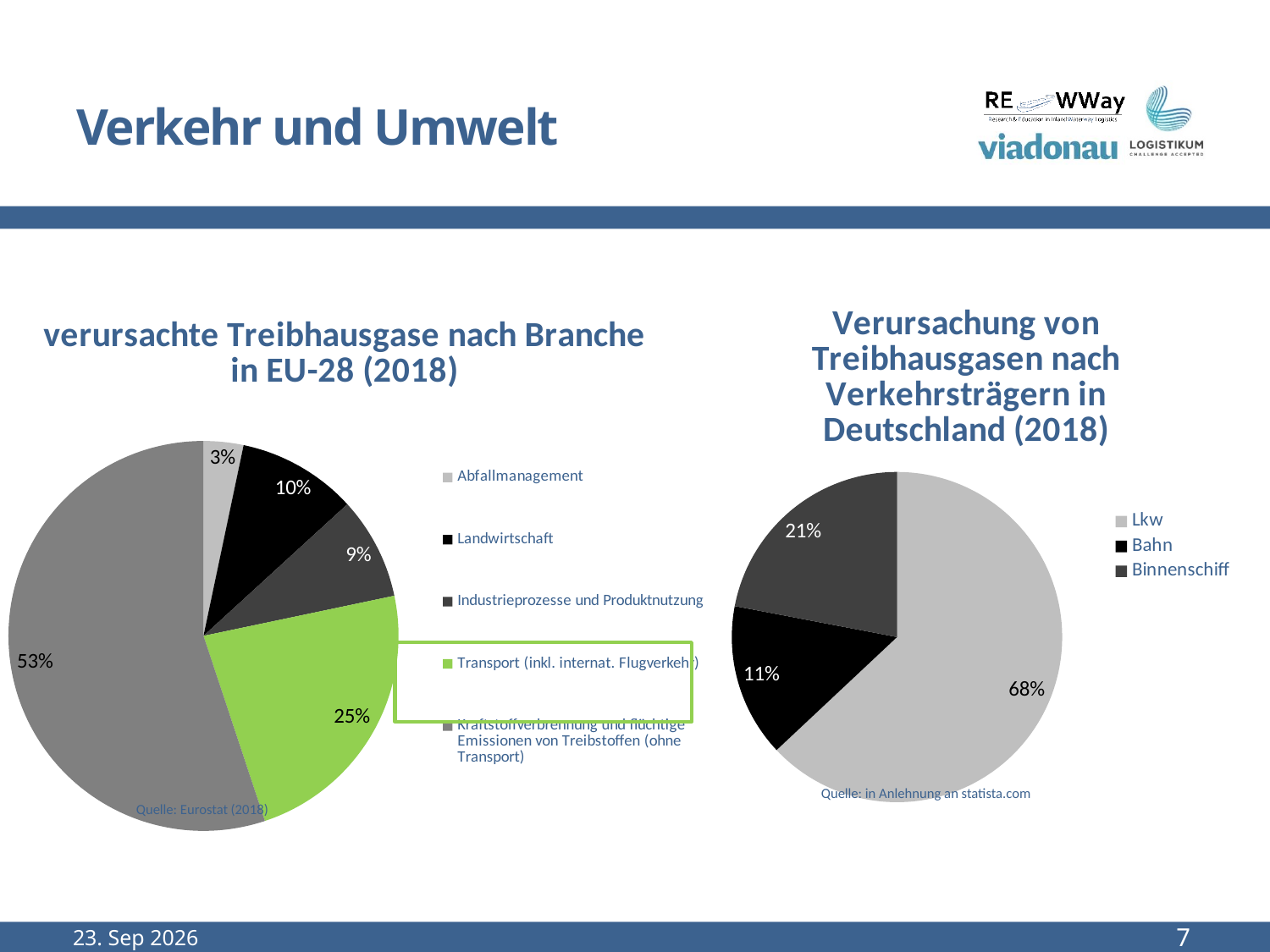
What type of chart is 'verursachte Treibhausgase nach Branche in EU-28 (2018)'? Pie chart In the chart 'verursachte Treibhausgase nach Branche in EU-28 (2018)', which category has the largest share? Kraftstoffverbrennung und flüchtige Emissionen von Treibstoffen (ohne Transport) In the chart 'verursachte Treibhausgase nach Branche in EU-28 (2018)', how many categories does the legend list? 5 In the chart 'Verursachung von Treibhausgasen nach Verkehrsträgern in Deutschland (2018)', which category has the smallest share? Bahn In the chart 'Verursachung von Treibhausgasen nach Verkehrsträgern in Deutschland (2018)', what share does Lkw have? 68% In the chart 'verursachte Treibhausgase nach Branche in EU-28 (2018)', which category has the smallest share? Abfallmanagement In the chart 'Verursachung von Treibhausgasen nach Verkehrsträgern in Deutschland (2018)', what share does Binnenschiff have? 21% In the chart 'Verursachung von Treibhausgasen nach Verkehrsträgern in Deutschland (2018)', which is larger, Bahn or Binnenschiff? Binnenschiff In the chart 'Verursachung von Treibhausgasen nach Verkehrsträgern in Deutschland (2018)', what colour is the Lkw slice? Light grey In the chart 'verursachte Treibhausgase nach Branche in EU-28 (2018)', what share does Landwirtschaft have? 10% In the chart 'verursachte Treibhausgase nach Branche in EU-28 (2018)', what share does Transport (inkl. internat. Flugverkehr) have? 25% In the chart 'verursachte Treibhausgase nach Branche in EU-28 (2018)', what is the difference between the shares of Transport and Industrieprozesse und Produktnutzung? 16%